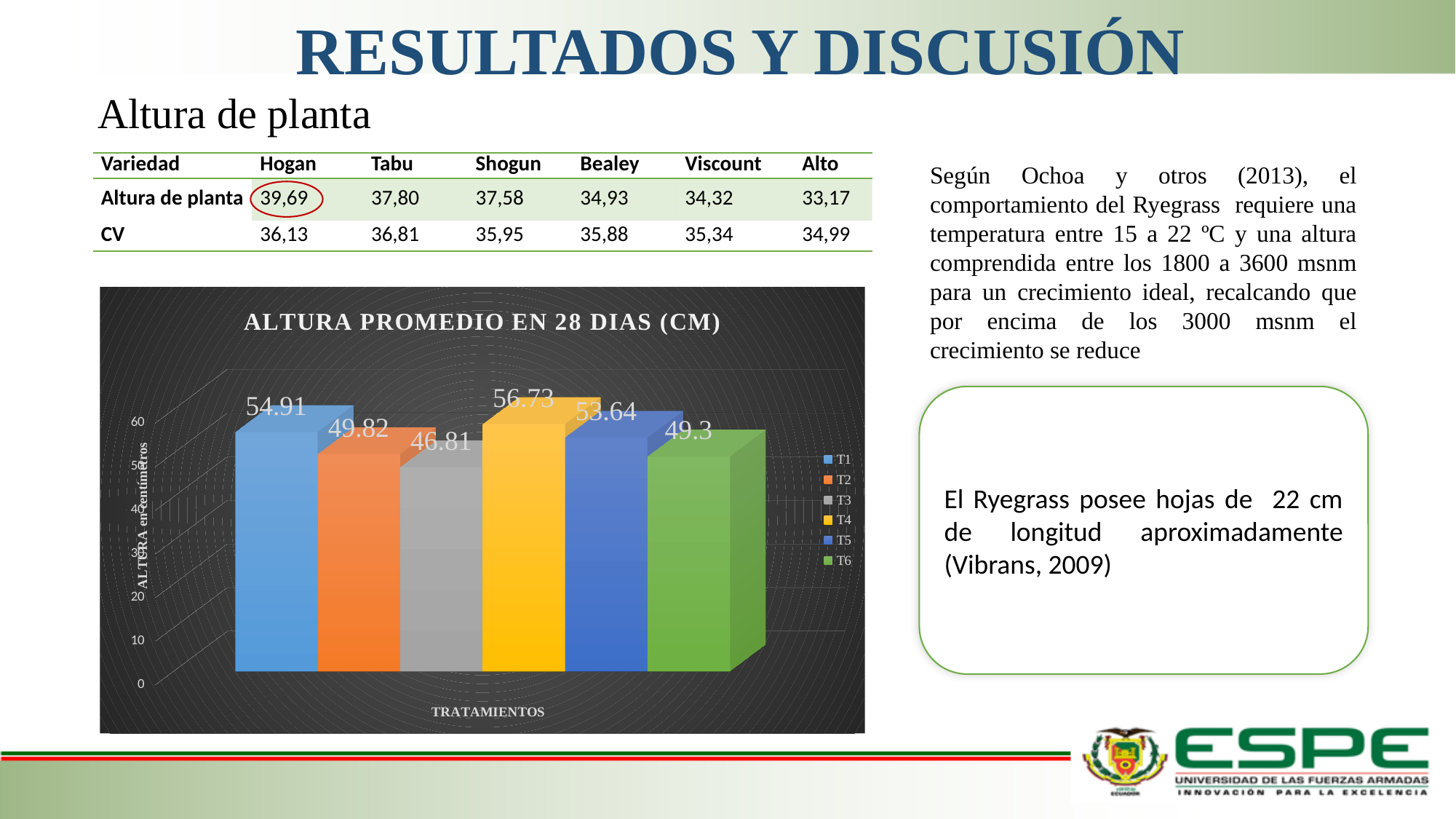
What is the value for T6 in the chart 'ALTURA PROMEDIO EN 28 DIAS (CM)'? 49.3 What is the value for T4 in the chart 'ALTURA PROMEDIO EN 28 DIAS (CM)'? 56.73 Which treatment has the highest value in the chart 'ALTURA PROMEDIO EN 28 DIAS (CM)'? T4 Is the value for T1 in the chart 'ALTURA PROMEDIO EN 28 DIAS (CM)' greater or less than 50? greater What is the x-axis title of the chart 'ALTURA PROMEDIO EN 28 DIAS (CM)'? TRATAMIENTOS Which treatment has the lowest value in the chart 'ALTURA PROMEDIO EN 28 DIAS (CM)'? T3 How many series does the legend of the chart 'ALTURA PROMEDIO EN 28 DIAS (CM)' list? 6 What is the value for T3 in the chart 'ALTURA PROMEDIO EN 28 DIAS (CM)'? 46.81 Which is larger in the chart 'ALTURA PROMEDIO EN 28 DIAS (CM)', the value for T2 or the value for T5? T5 What kind of chart is 'ALTURA PROMEDIO EN 28 DIAS (CM)'? bar chart What is the difference between the values for T4 and T3 in the chart 'ALTURA PROMEDIO EN 28 DIAS (CM)'? 9.92 What is the value for T1 in the chart 'ALTURA PROMEDIO EN 28 DIAS (CM)'? 54.91